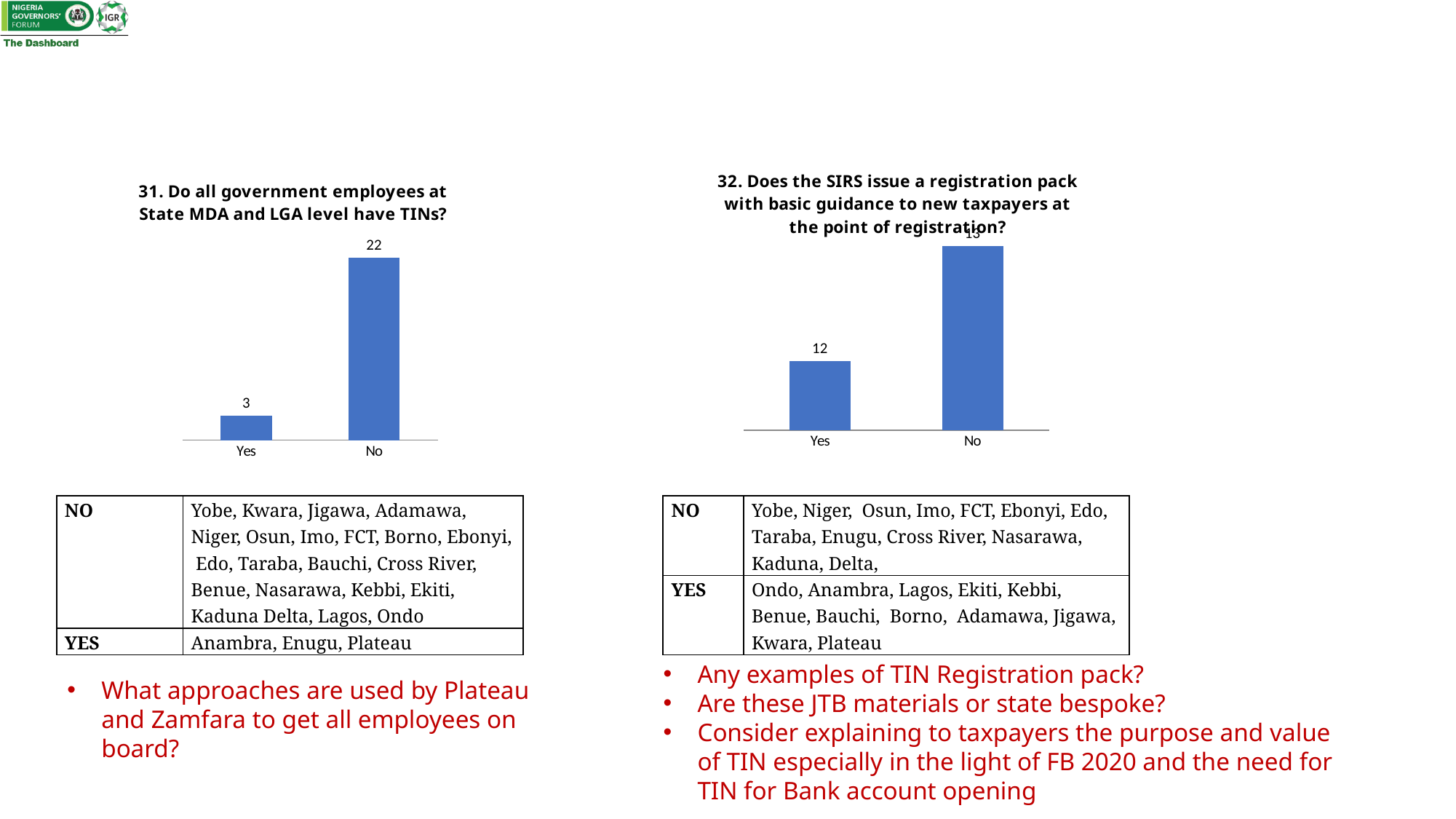
In the chart titled "32. Does the SIRS issue a registration pack with basic guidance to new taxpayers at the point of registration?", what is the value for No? 13 In the right chart (question 32), which category has the lowest value? Yes In the right chart (question 32), is the value for Yes or No larger? No In the chart titled "31. Do all government employees at State MDA and LGA level have TINs?", what is the value for No? 22 In the left chart (question 31), what is the difference between the No and Yes values? 19 In the chart titled "31. Do all government employees at State MDA and LGA level have TINs?", what is the value for Yes? 3 In the chart titled "32. Does the SIRS issue a registration pack with basic guidance to new taxpayers at the point of registration?", what is the value for Yes? 12 What are the category labels on the x axis of the left chart (question 31)? Yes, No In the right chart (question 32), what is the difference between the No and Yes values? 1 In the left chart (question 31), which category has the highest value? No How many categories are shown in the left chart (question 31)? 2 What type of chart is used for question 32 on the right of the slide? Bar chart